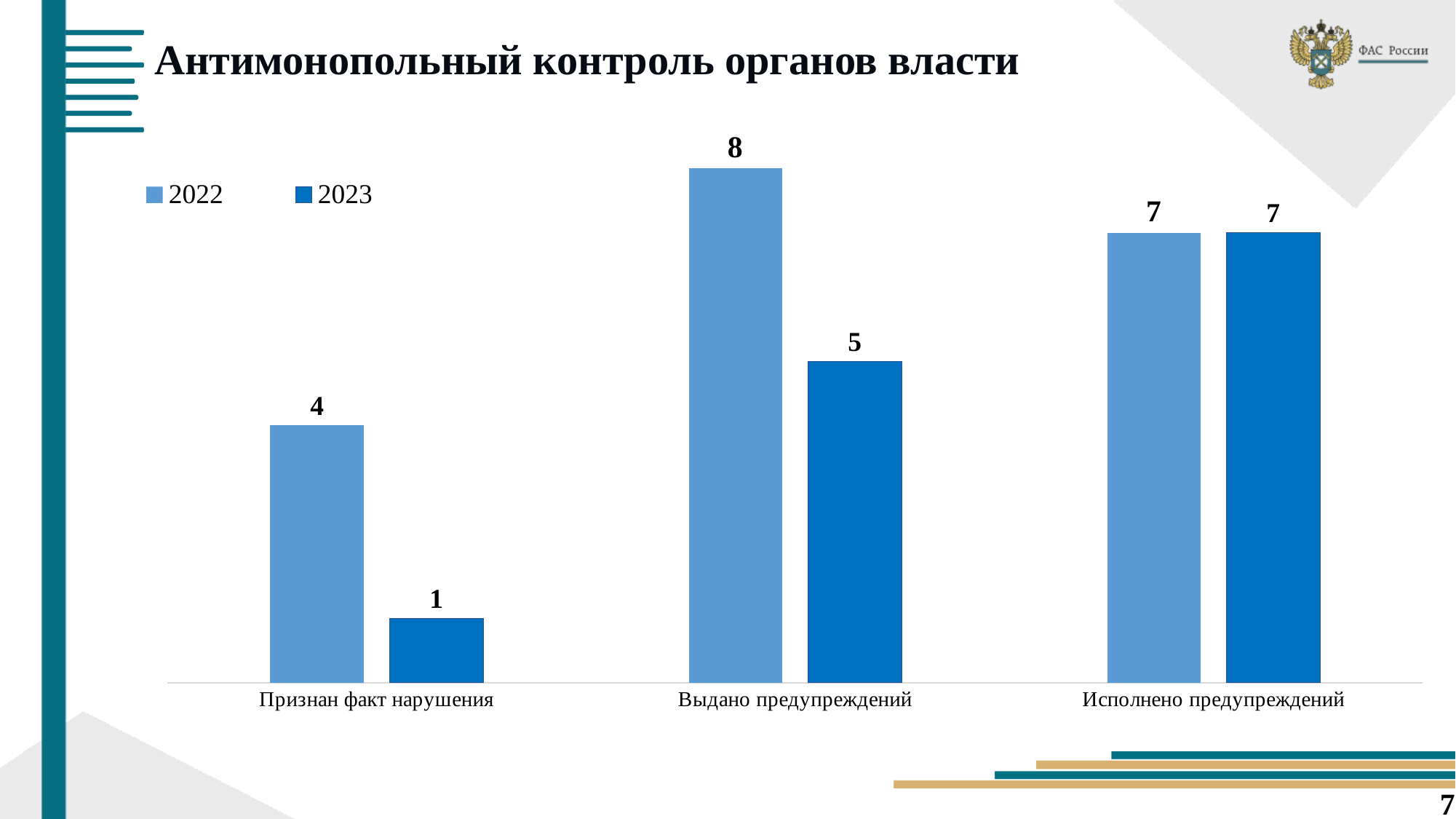
What is the value for 2023 in the category "Исполнено предупреждений"? 7 Which is larger for "Признан факт нарушения": the 2022 value or the 2023 value? 2022 How many categories are shown on the x axis? 3 What is the difference between the 2022 and 2023 values for "Признан факт нарушения"? 3 What kind of chart is shown on the slide? Bar chart How many series does the legend list? 2 What is the value for 2022 in the category "Признан факт нарушения"? 4 What is the value for 2023 in the category "Выдано предупреждений"? 5 What is the value for 2023 in the category "Признан факт нарушения"? 1 Which category has the highest value for 2022? Выдано предупреждений Which category has the lowest value for 2023? Признан факт нарушения What is the difference between the 2022 and 2023 values for "Выдано предупреждений"? 3